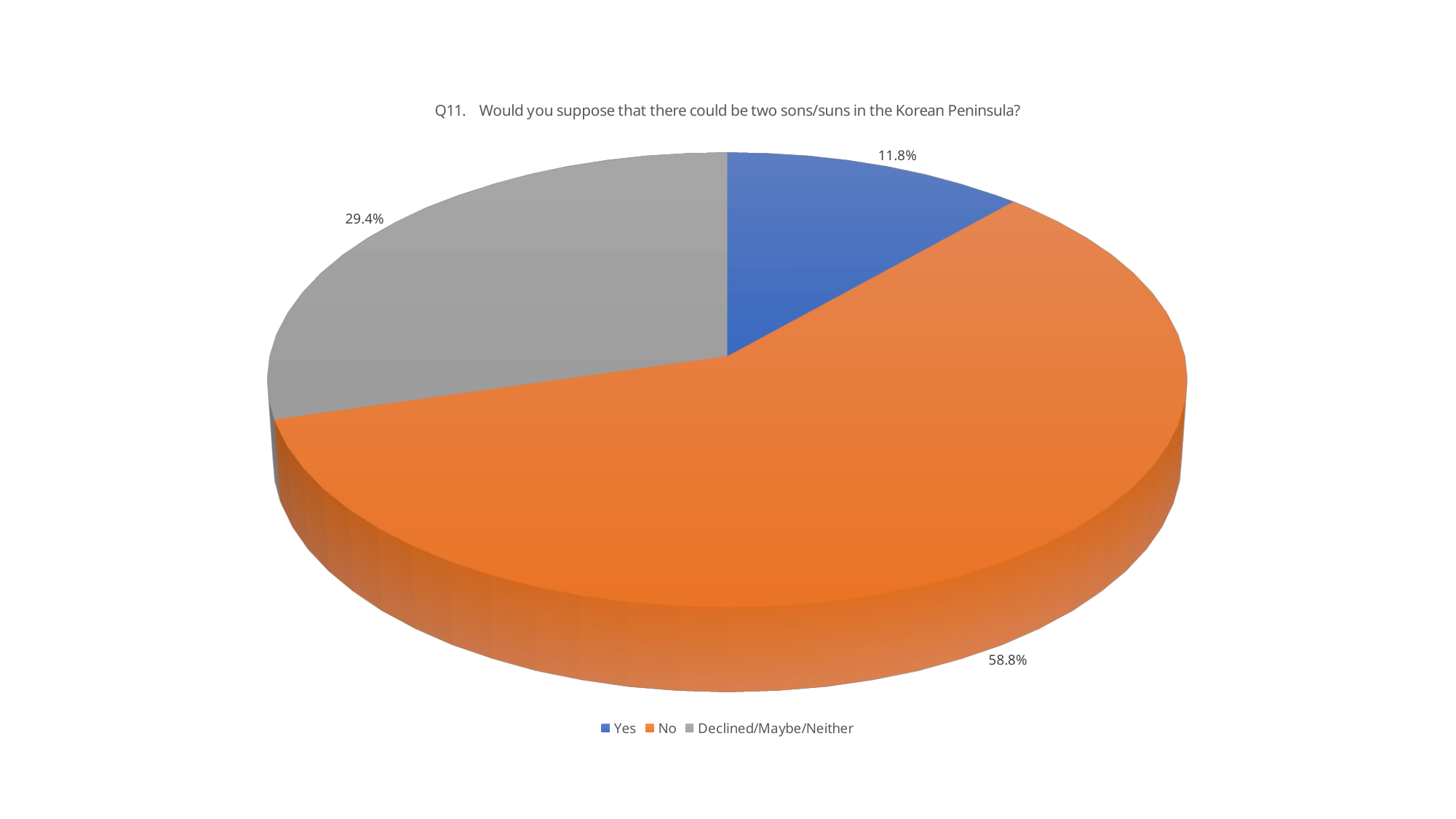
What percentage of respondents answered "Declined/Maybe/Neither"? 29.4% What is the difference in percentage points between the "Declined/Maybe/Neither" and "Yes" shares? 17.6 percentage points What is the title of the chart? Q11. Would you suppose that there could be two sons/suns in the Korean Peninsula? How many slices does the pie chart have? 3 What percentage of respondents answered "No"? 58.8% What colour is the "No" slice in the pie chart? Orange Which response has the largest share of the pie? No Which response has the smallest share of the pie? Yes What kind of chart is shown on the slide? Pie chart What is the difference in percentage points between the "No" and "Yes" shares? 47.0 percentage points What percentage of respondents answered "Yes"? 11.8% Which is larger, the share for "No" or the share for "Declined/Maybe/Neither"? No